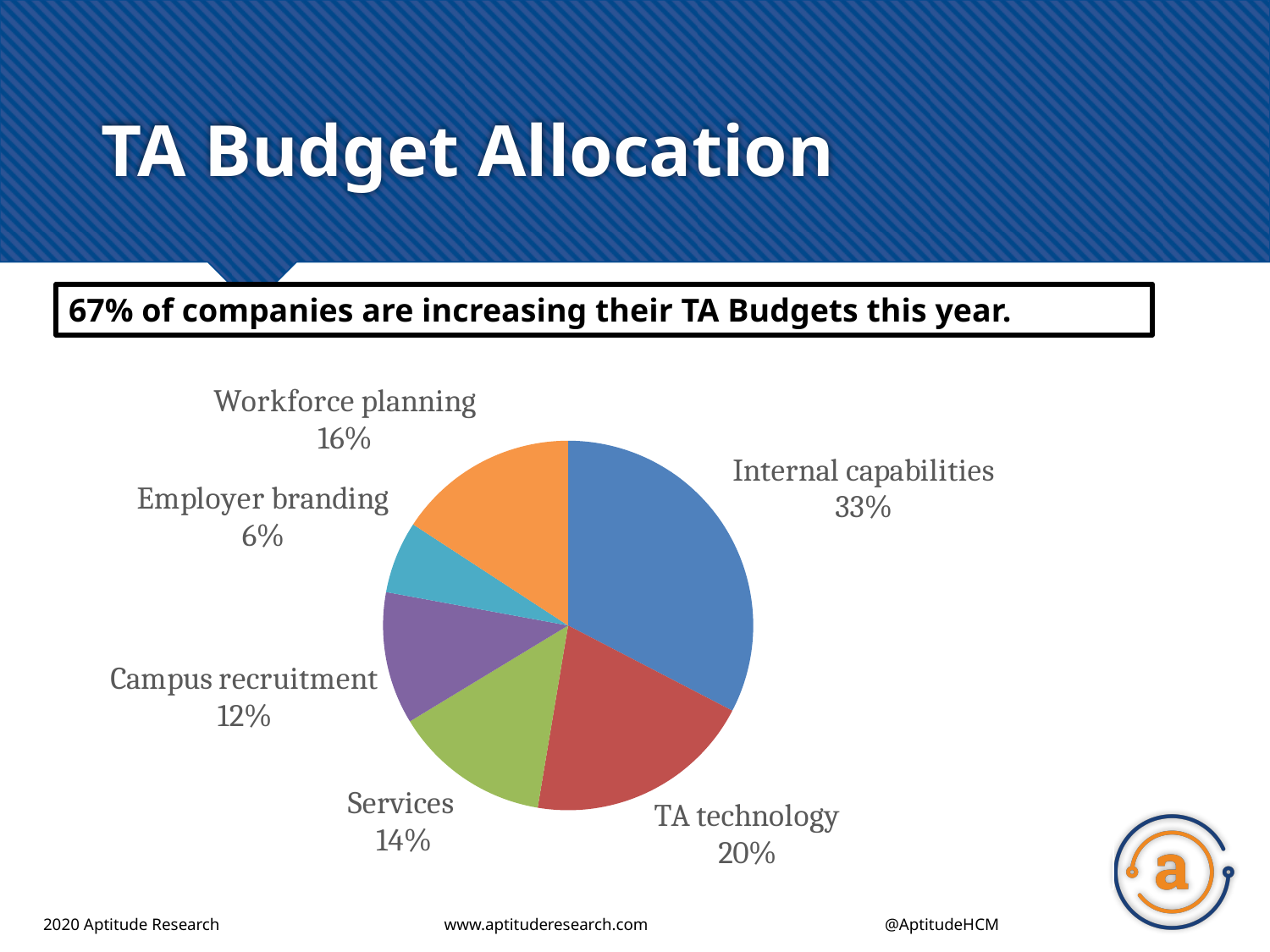
Which category receives the largest share of the TA budget? Internal capabilities What share of the TA budget is allocated to Employer branding? 6% Which is larger, the share for Workforce planning or the share for Services? Workforce planning What share of the TA budget is allocated to Campus recruitment? 12% Which category receives the smallest share of the TA budget? Employer branding What kind of chart is shown on the slide? Pie chart What share of the TA budget is allocated to TA technology? 20% What is the combined share of Workforce planning and Employer branding? 22% What is the difference in percentage points between Internal capabilities and TA technology? 13 How many categories are shown in the pie chart? 6 What is the title of the slide containing the chart? TA Budget Allocation What share of the TA budget is allocated to Internal capabilities? 33%